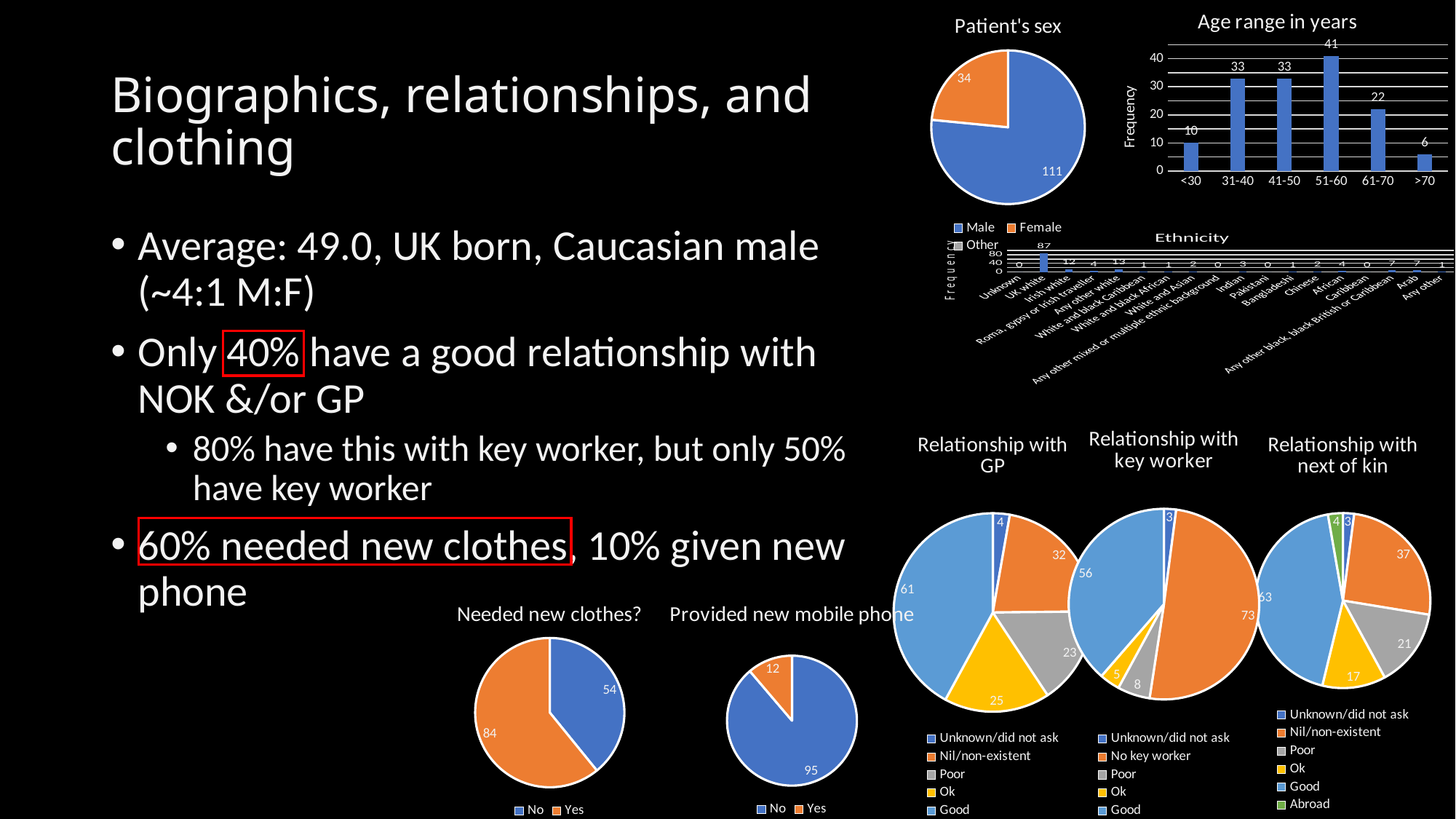
In the 'Relationship with GP' pie chart, what is the value for Poor? 23 In the 'Age range in years' bar chart, how many age ranges are shown on the x axis? 6 In the 'Ethnicity' bar chart, what is the value for UK white? 87 In the 'Age range in years' bar chart, what is the frequency for the >70 age range? 6 In the 'Age range in years' bar chart, what is the difference between the frequencies for 51-60 and 61-70? 19 In the 'Provided new mobile phone' pie chart, which is larger, No or Yes? No In the 'Age range in years' bar chart, which age range has the highest frequency? 51-60 How many entries does the legend of the 'Relationship with next of kin' pie chart list? 6 In the 'Relationship with key worker' pie chart, which category has the largest slice? No key worker In the 'Needed new clothes?' pie chart, what is the value for Yes? 84 In the 'Relationship with next of kin' pie chart, what is the value for Abroad? 4 In the 'Patient's sex' pie chart, how many patients are male? 111